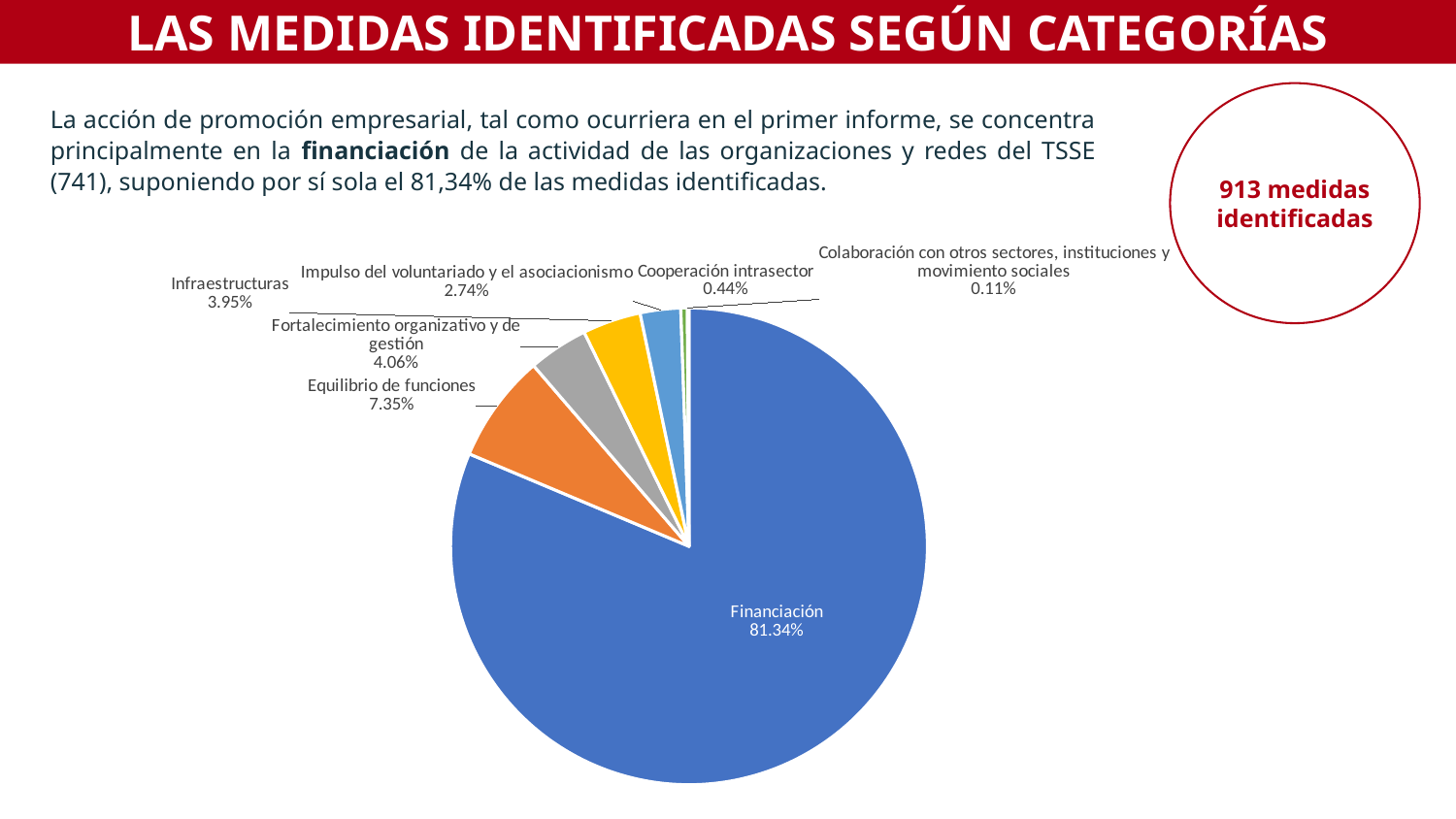
What is the value shown for Infraestructuras? 3.95% What is the value shown for Impulso del voluntariado y el asociacionismo? 2.74% What is the value shown for Cooperación intrasector? 0.44% Which category has the smallest slice of the pie? Colaboración con otros sectores, instituciones y movimiento sociales What is the difference between the shares of Equilibrio de funciones and Infraestructuras? 3.40% Which is larger, the share for Fortalecimiento organizativo y de gestión or the share for Impulso del voluntariado y el asociacionismo? Fortalecimiento organizativo y de gestión What is the value shown for Fortalecimiento organizativo y de gestión? 4.06% What share of the pie does Financiación represent? 81.34% What is the value shown for Equilibrio de funciones? 7.35% What kind of chart is shown on the slide? Pie chart How many categories are shown in the pie chart? 7 Which category has the largest slice of the pie? Financiación